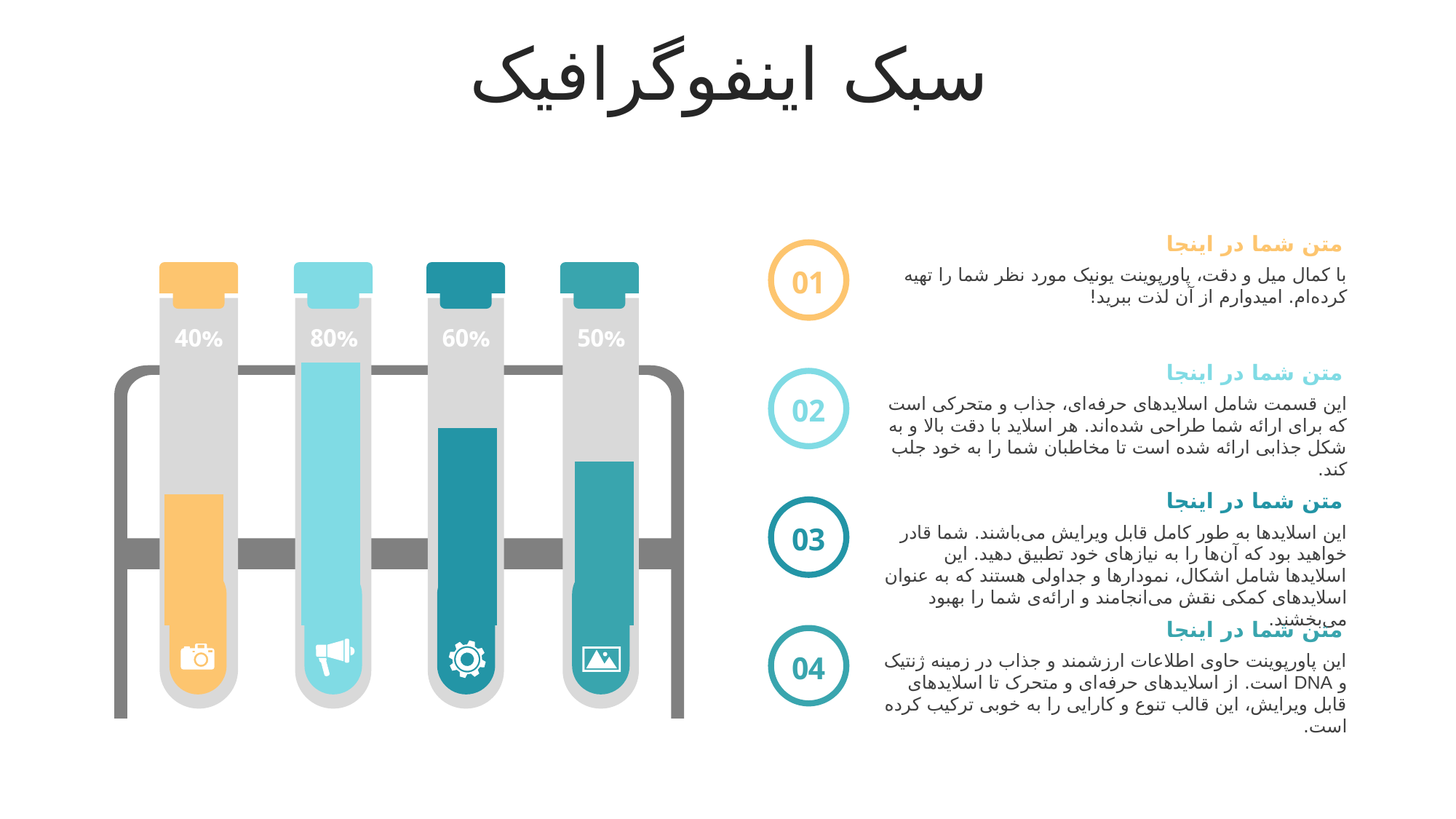
What icon appears at the bottom of the orange test tube? A camera Which test tube shows the highest percentage? The light blue one (second from left), 80% Is the percentage on the orange test tube greater or less than 50%? less What is the difference between the percentages on the third and fourth test tubes from the left? 10% Which is larger, the percentage on the gear-icon tube or the picture-icon tube? The gear-icon tube (60%) Which test tube shows the lowest percentage? The orange one (first from left), 40% What percentage is shown on the fourth test tube from the left (with the picture icon)? 50% What percentage is shown on the light blue test tube with the megaphone icon? 80% What percentage is shown on the dark teal test tube with the gear icon? 60% How many test tubes are shown in the infographic? 4 What is the difference between the percentages on the second and first test tubes from the left? 40% What percentage is shown on the orange test tube (first from the left)? 40%